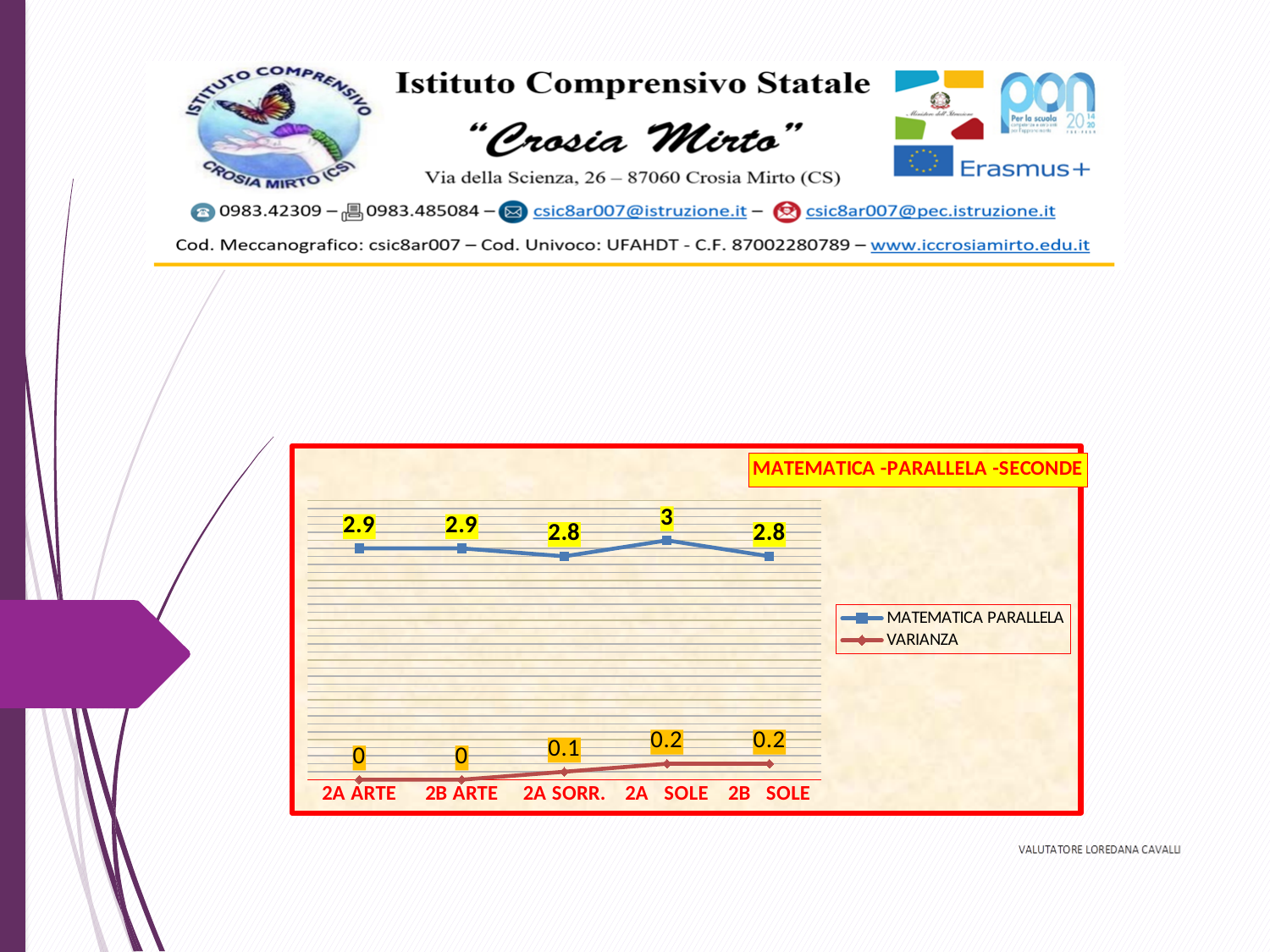
What is the VARIANZA value for 2A ARTE? 0 What is the MATEMATICA PARALLELA value for 2A SORR.? 2.8 What is the difference between the MATEMATICA PARALLELA values for 2A SOLE and 2B SOLE? 0.2 What is the title of the chart? MATEMATICA -PARALLELA -SECONDE Which category has the highest MATEMATICA PARALLELA value? 2A SOLE What is the MATEMATICA PARALLELA value for 2A SOLE? 3 How many series does the legend list? 2 What kind of chart is shown on the slide? line chart How many categories are shown on the x axis? 5 What is the VARIANZA value for 2B SOLE? 0.2 Does the VARIANZA series rise or fall from 2A ARTE to 2B SOLE? rise Which is larger, the VARIANZA value for 2A SORR. or for 2A SOLE? 2A SOLE